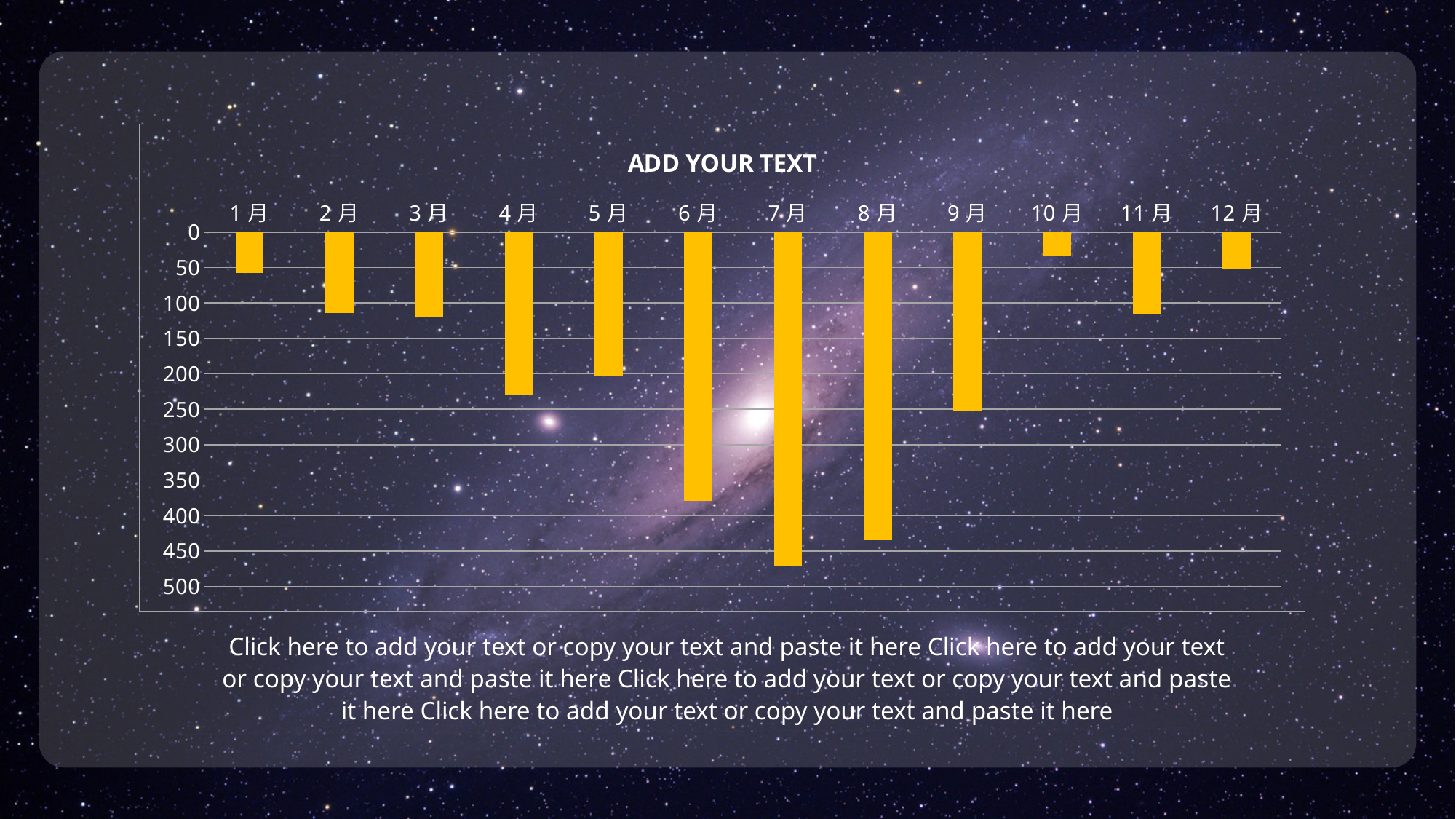
Do the bar values generally rise or fall from 1月 to 7月? rise Is the value for 10月 greater or less than 50? less Which has the larger value, 8月 or 9月? 8月 What kind of chart is shown on the slide? Bar chart What is the title of the chart? ADD YOUR TEXT How many categories (months) are plotted on the chart? 12 Is the value for 4月 greater or less than 200? greater Which has the larger value, 6月 or 4月? 6月 Is the value for 7月 greater or less than 400? greater Which month has the shortest bar on the chart? 10月 Which month has the longest bar on the chart? 7月